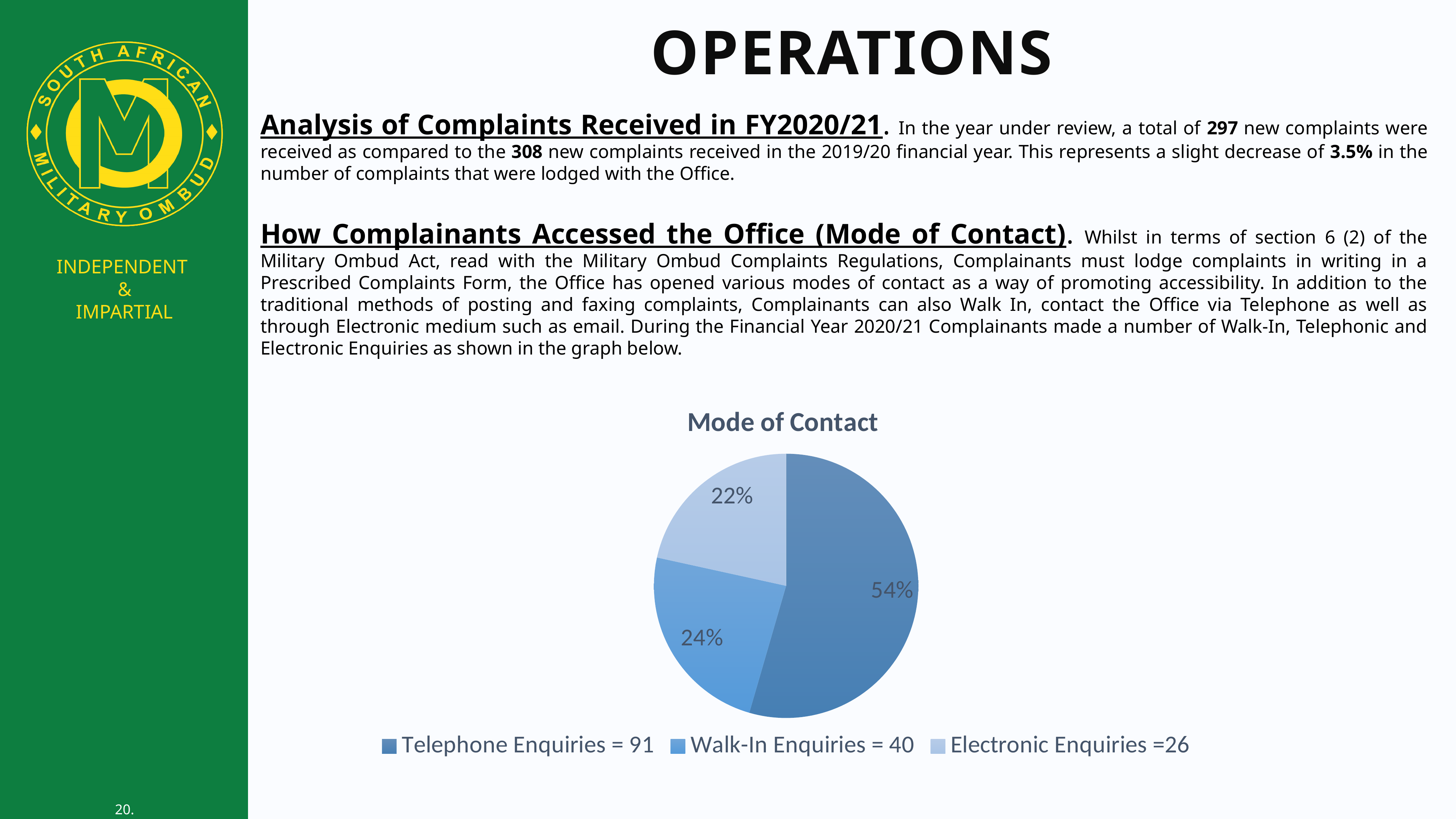
What percentage of the Mode of Contact pie is Walk-In Enquiries? 24% Which mode of contact has the largest share of the pie? Telephone Enquiries What percentage of the Mode of Contact pie is Telephone Enquiries? 54% What kind of chart is shown on the slide? pie chart What is the title of the chart on the slide? Mode of Contact According to the legend, how many Walk-In Enquiries were there? 40 How many entries does the legend of the Mode of Contact chart list? 3 According to the legend, how many Telephone Enquiries were there? 91 What percentage of the Mode of Contact pie is Electronic Enquiries? 22% Which mode of contact has the smallest share of the pie? Electronic Enquiries How many slices does the Mode of Contact pie chart have? 3 How many more Telephone Enquiries were there than Walk-In Enquiries? 51